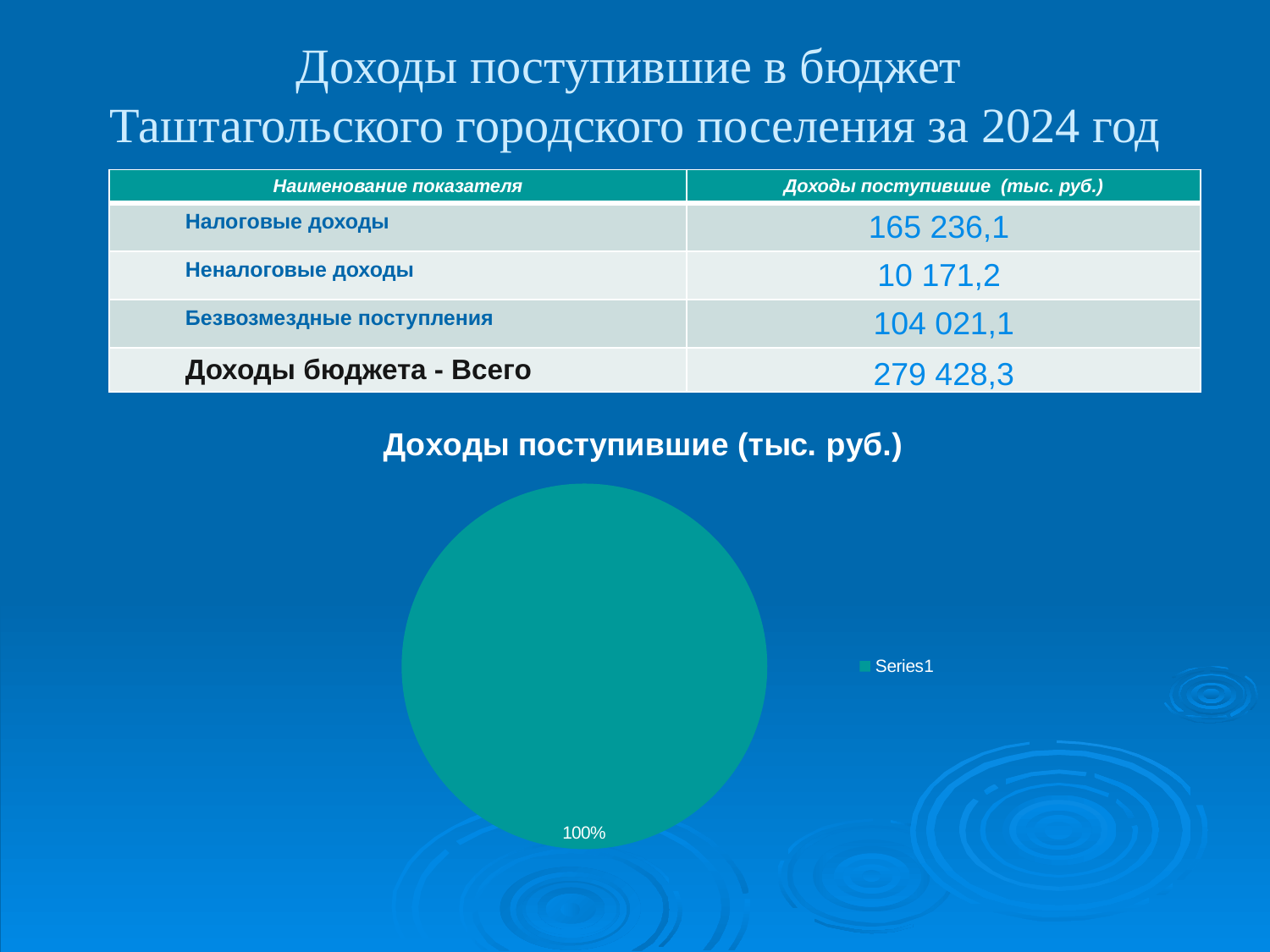
How many series does the chart legend list? 1 What is the name of the series shown in the chart legend? Series1 How many slices does the pie chart have? 1 What share of the pie does the single slice represent? 100% What kind of chart is shown on the slide? pie chart What is the title of the pie chart? Доходы поступившие (тыс. руб.)